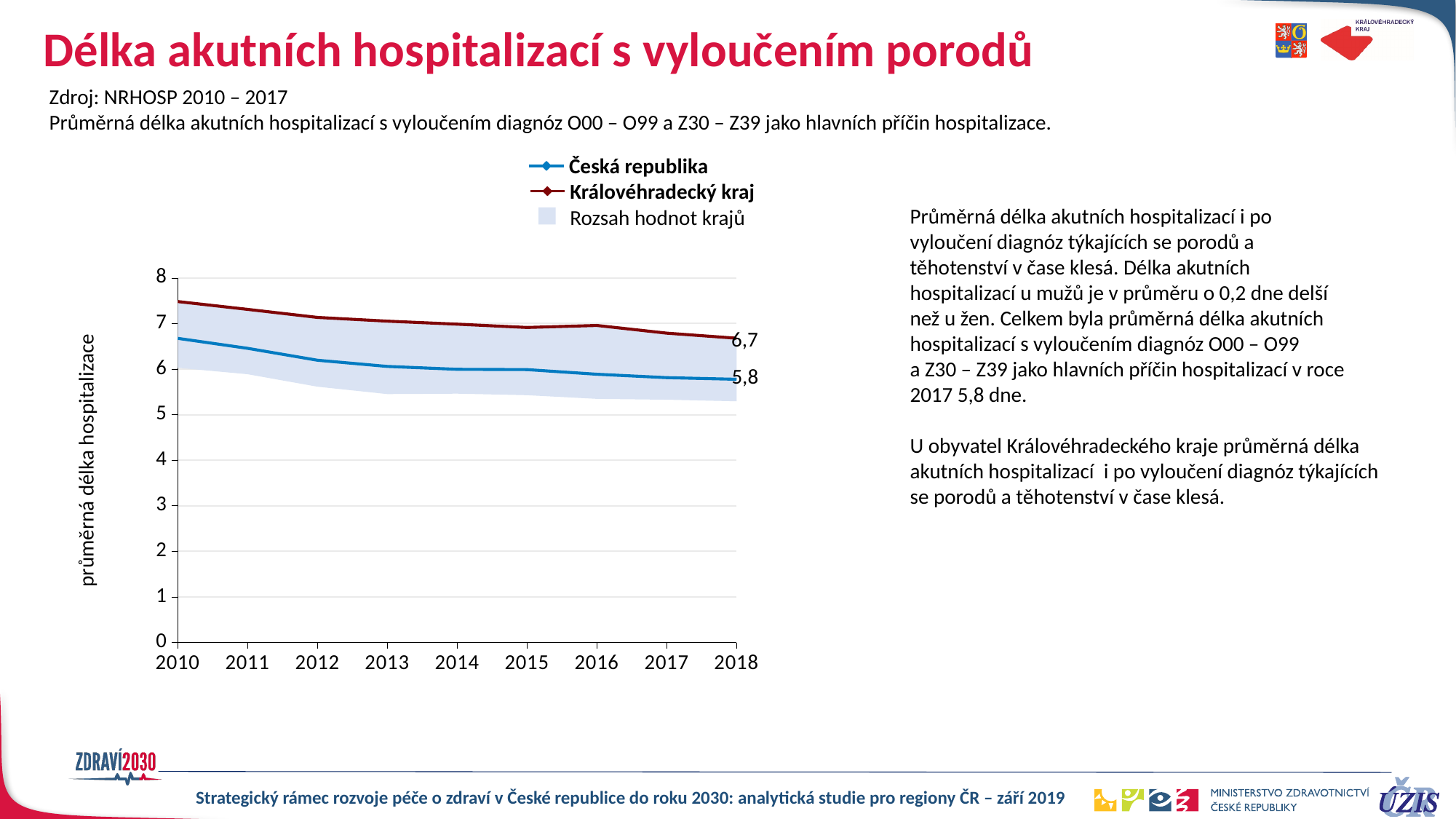
Do the values of the Česká republika line rise or fall over the years shown? fall What is the value printed at the right end of the Česká republika line? 5,8 What is the difference between the final printed values of Královéhradecký kraj (6,7) and Česká republika (5,8)? 0,9 What is the label of the vertical axis? průměrná délka hospitalizace What does the shaded band in the chart represent, according to the legend? Rozsah hodnot krajů How many year labels are shown on the x axis? 9 Is the value for Královéhradecký kraj in 2010 greater or less than 7? greater What kind of chart is shown on the slide? line chart At the right end of the chart, which series has the higher value: Česká republika or Královéhradecký kraj? Královéhradecký kraj How many entries does the chart legend list? 3 Is the value for Česká republika in 2010 greater or less than 6? greater What is the value printed at the right end of the Královéhradecký kraj line? 6,7